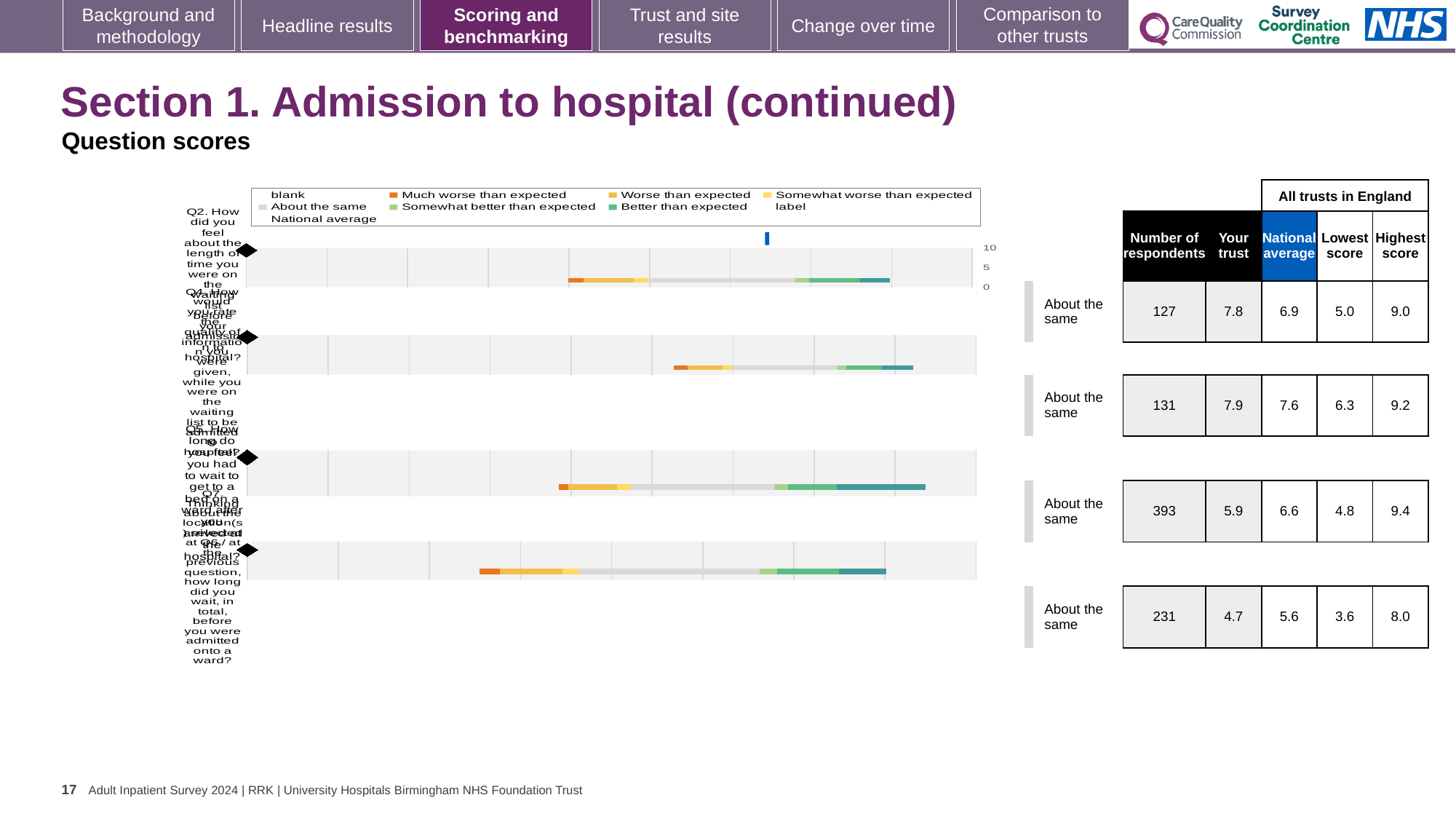
How many respondents are listed for the third question row in the chart? 393 What benchmark category is shown for every question row in the chart? About the same Which question row has the highest 'Your trust' score? the second row (7.9) How many question rows (bars) are plotted in the chart? 4 What is the 'Your trust' score for the first (top) question row in the chart? 7.8 What kind of chart is shown on the slide? bar chart What is the difference between the highest score and the lowest score for the third question row? 4.6 Which question row has the lowest 'Your trust' score? the fourth row (4.7) For the fourth question row, is the 'Your trust' score or the national average larger? national average Which colour does the legend use for 'Much worse than expected'? orange What is the 'Your trust' score for the fourth (bottom) question row in the chart? 4.7 What is the national average for the second question row in the chart? 7.6